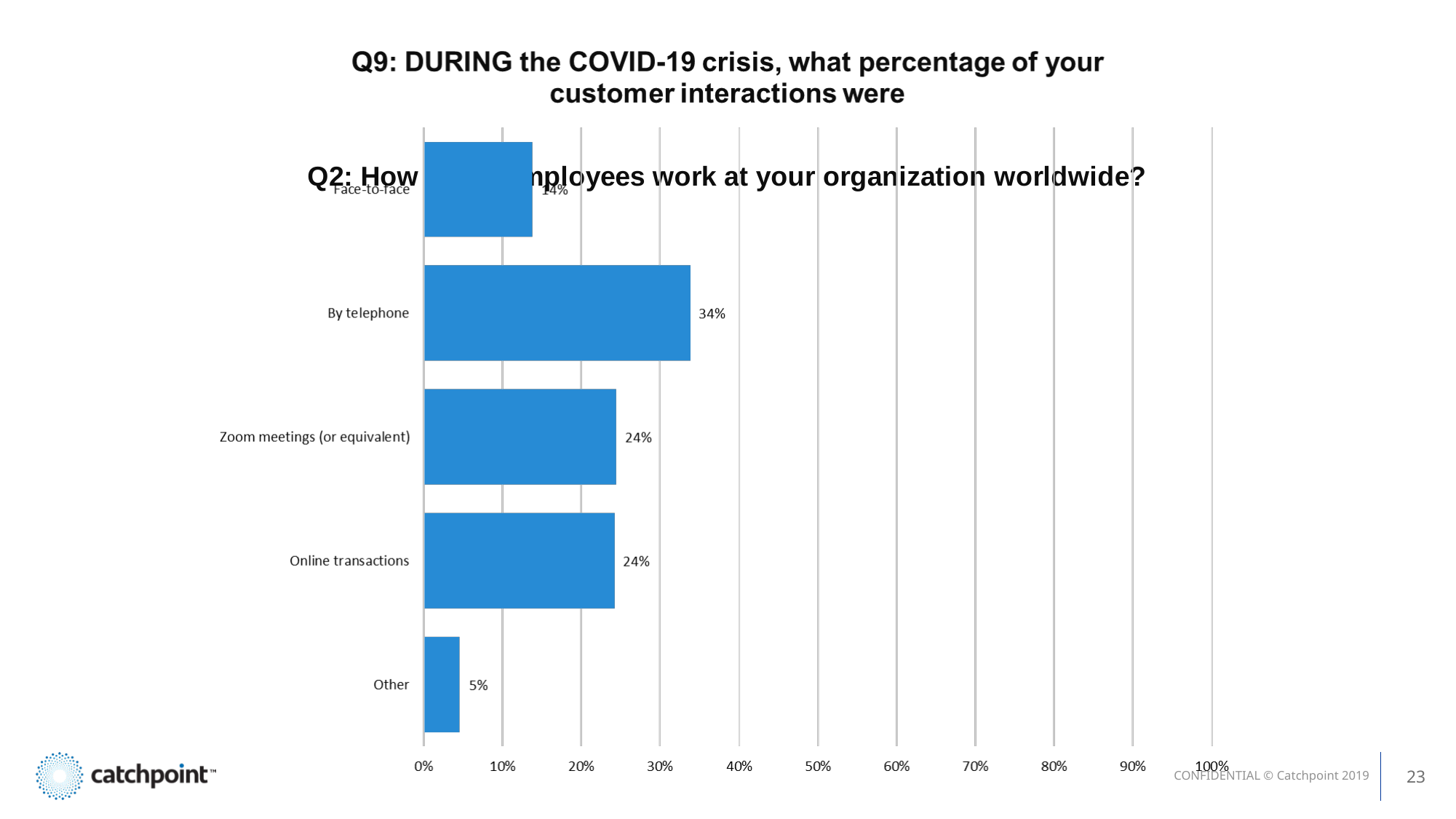
What percentage of customer interactions were online transactions? 24% What is the difference between the percentage for By telephone and the percentage for Zoom meetings (or equivalent)? 10% What percentage of customer interactions were Zoom meetings (or equivalent)? 24% How many categories are shown in the chart? 5 Which category has the lowest percentage of customer interactions? Other What kind of chart is shown on the slide? bar chart Is the value for Face-to-face greater or less than 20%? less Which category has the highest percentage of customer interactions? By telephone Which is larger, the value for By telephone or the value for Online transactions? By telephone What percentage of customer interactions fall under Other? 5% What is the difference between the percentage for By telephone and the percentage for Other? 29% What percentage of customer interactions were by telephone? 34%